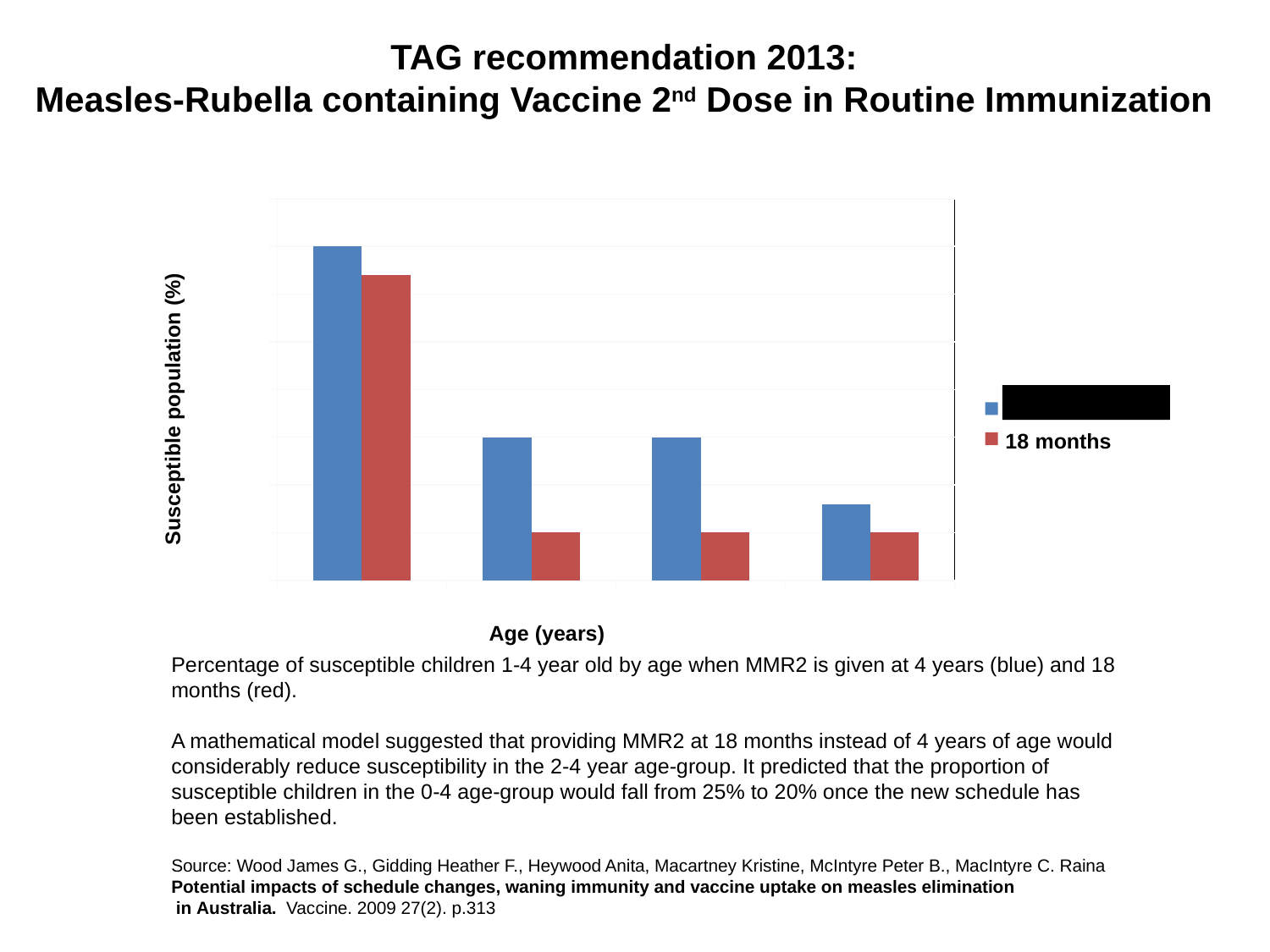
Which group of bars has the highest value for the 18 months series? The leftmost group What kind of chart is shown on the slide? Bar chart Do the values of the blue series generally rise or fall from left to right along the x axis? Fall Which group of bars has the lowest value for the blue series? The rightmost group How many series does the chart's legend list? 2 In the leftmost group of bars, which series has the larger value, the blue series or the 18 months series? The blue series What is the title of the chart's horizontal axis? Age (years) What is the title of the chart's vertical axis? Susceptible population (%) How many groups of bars are plotted along the x axis? 4 Do the values of the 18 months series rise or fall from the first group to the second group of bars? Fall